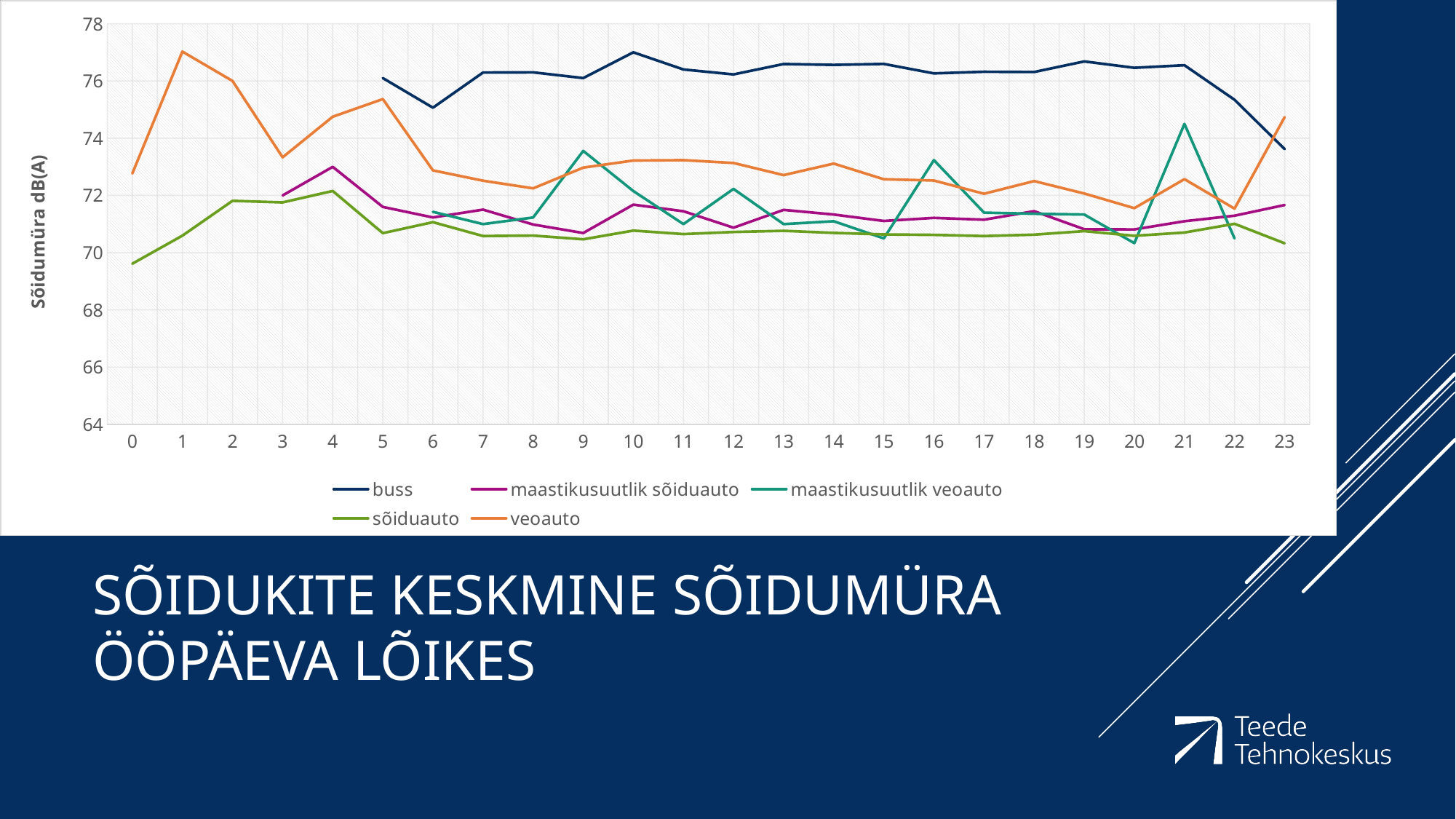
What kind of chart is shown on the slide? line chart At hour 1, which is larger: veoauto or sõiduauto? veoauto Is the value for sõiduauto at hour 0 greater or less than 70? less Is the value for buss at hour 10 greater or less than 76? greater Which series has the highest value at hour 15? buss Is the value for veoauto at hour 1 greater or less than 76? greater How many series does the legend list? 5 At hour 12, which is larger: buss or sõiduauto? buss Does the buss line rise or fall between hour 21 and hour 23? fall How many hour points are shown along the x axis? 24 What is the label on the y axis? Sõidumüra dB(A)